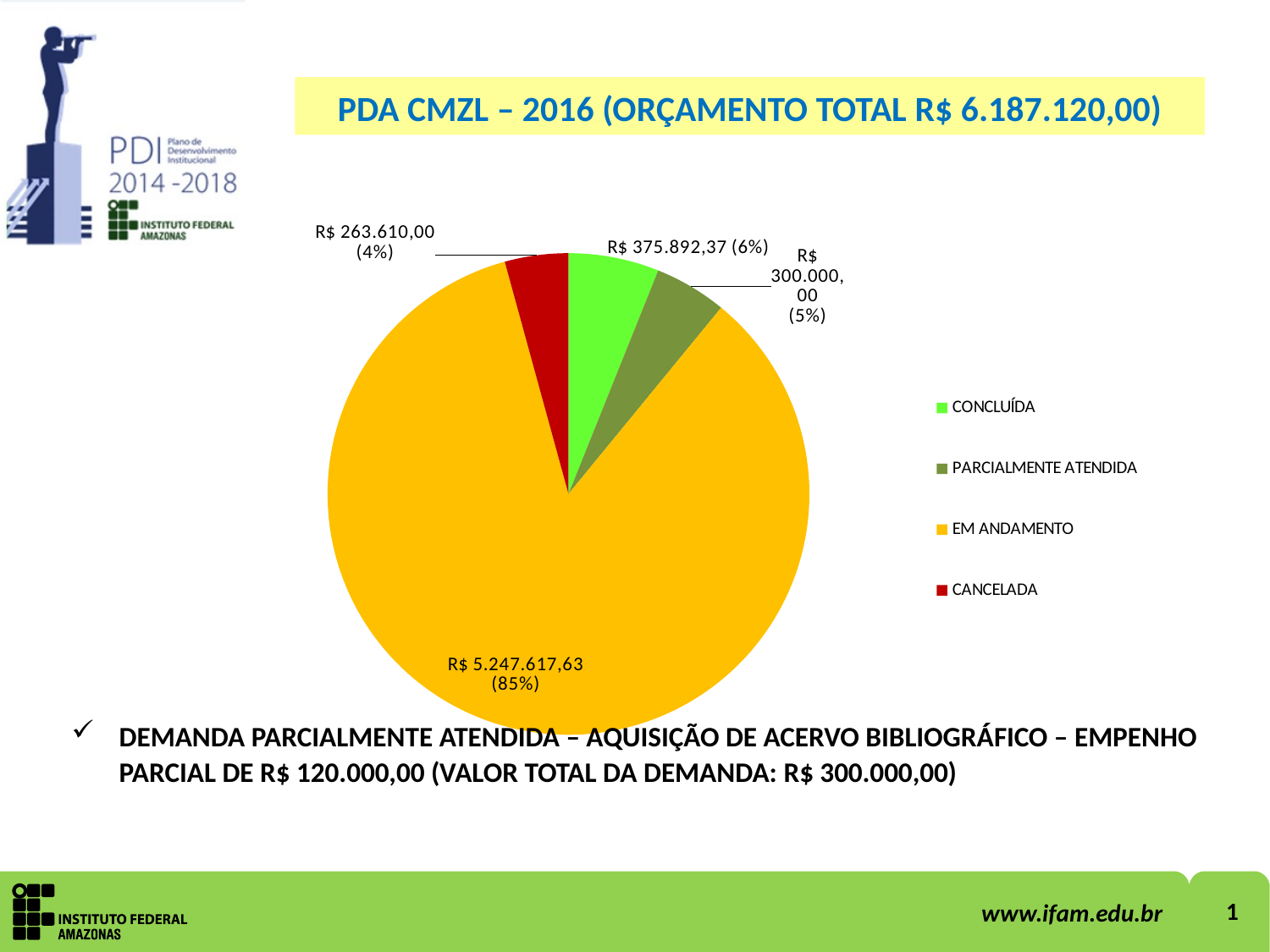
What is the value for EM ANDAMENTO? R$ 5.247.617,63 What is the value for PARCIALMENTE ATENDIDA? R$ 300.000,00 What share of the pie does EM ANDAMENTO represent? 85% How many categories does the legend list? 4 Which category has the largest slice of the pie? EM ANDAMENTO What is the value for CONCLUÍDA? R$ 375.892,37 What share of the pie does CONCLUÍDA represent? 6% Which category has the smallest slice of the pie? CANCELADA Which is larger, the value for CONCLUÍDA or the value for CANCELADA? CONCLUÍDA What is the title of the chart? PDA CMZL – 2016 (ORÇAMENTO TOTAL R$ 6.187.120,00) What kind of chart is shown on the slide? Pie chart What is the value for CANCELADA? R$ 263.610,00